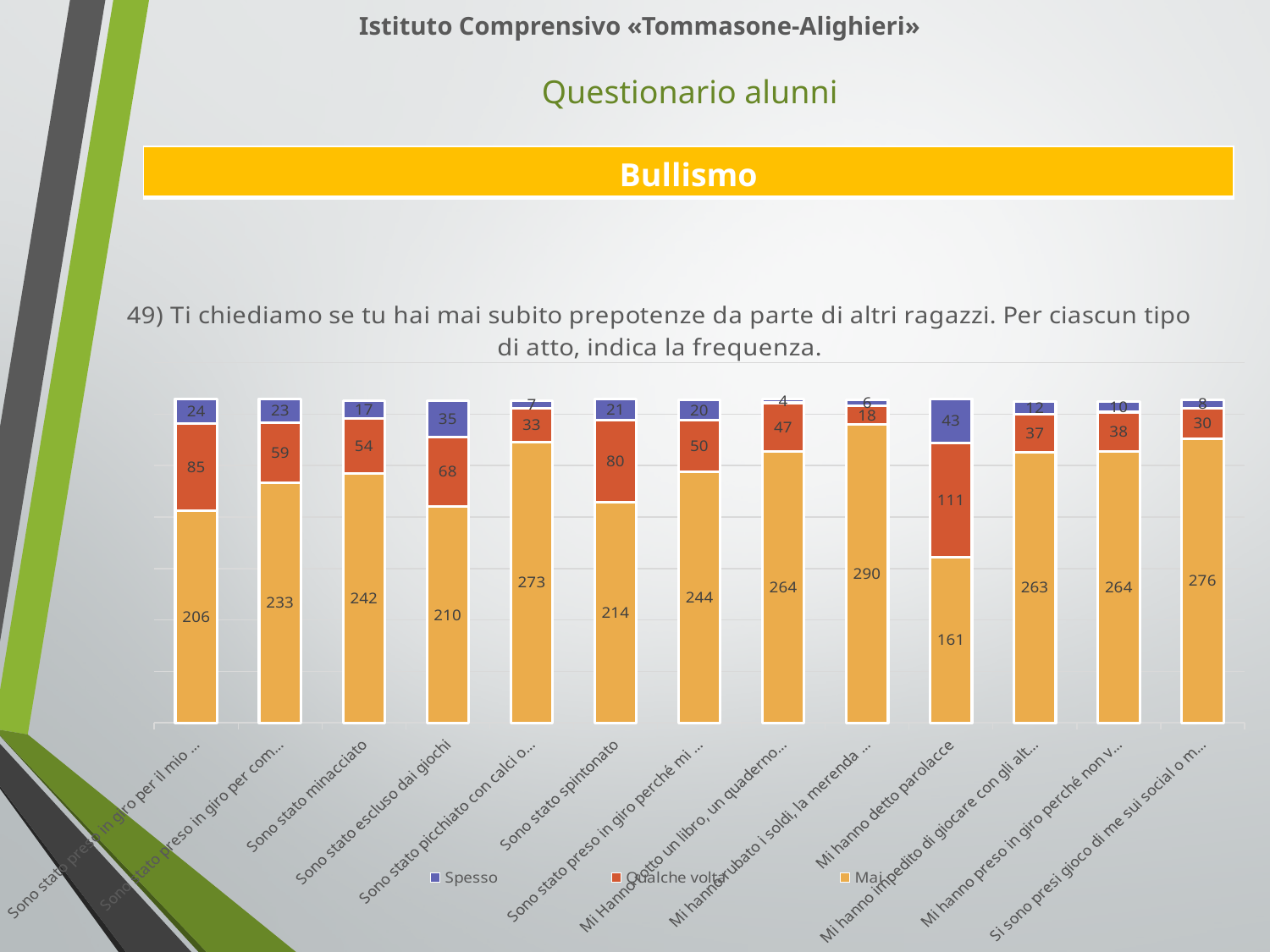
What is the 'Qualche volta' value for 'Sono stato spintonato'? 80 What is the 'Spesso' value for 'Sono stato escluso dai giochi'? 35 What type of chart is shown on the slide? stacked bar chart Which category has the lowest 'Mai' value? Mi hanno detto parolacce What is the 'Qualche volta' value for 'Mi hanno detto parolacce'? 111 How many categories are plotted in the chart? 13 What is the difference between the 'Mai' values for 'Sono stato minacciato' and 'Sono stato spintonato'? 28 Which is larger: the 'Qualche volta' value for 'Sono stato escluso dai giochi' or for 'Sono stato minacciato'? Sono stato escluso dai giochi What is the total of the stacked bar for 'Mi hanno detto parolacce'? 315 How many series does the legend list? 3 Which category has the highest 'Spesso' value? Mi hanno detto parolacce What is the 'Mai' value for 'Sono stato minacciato'? 242